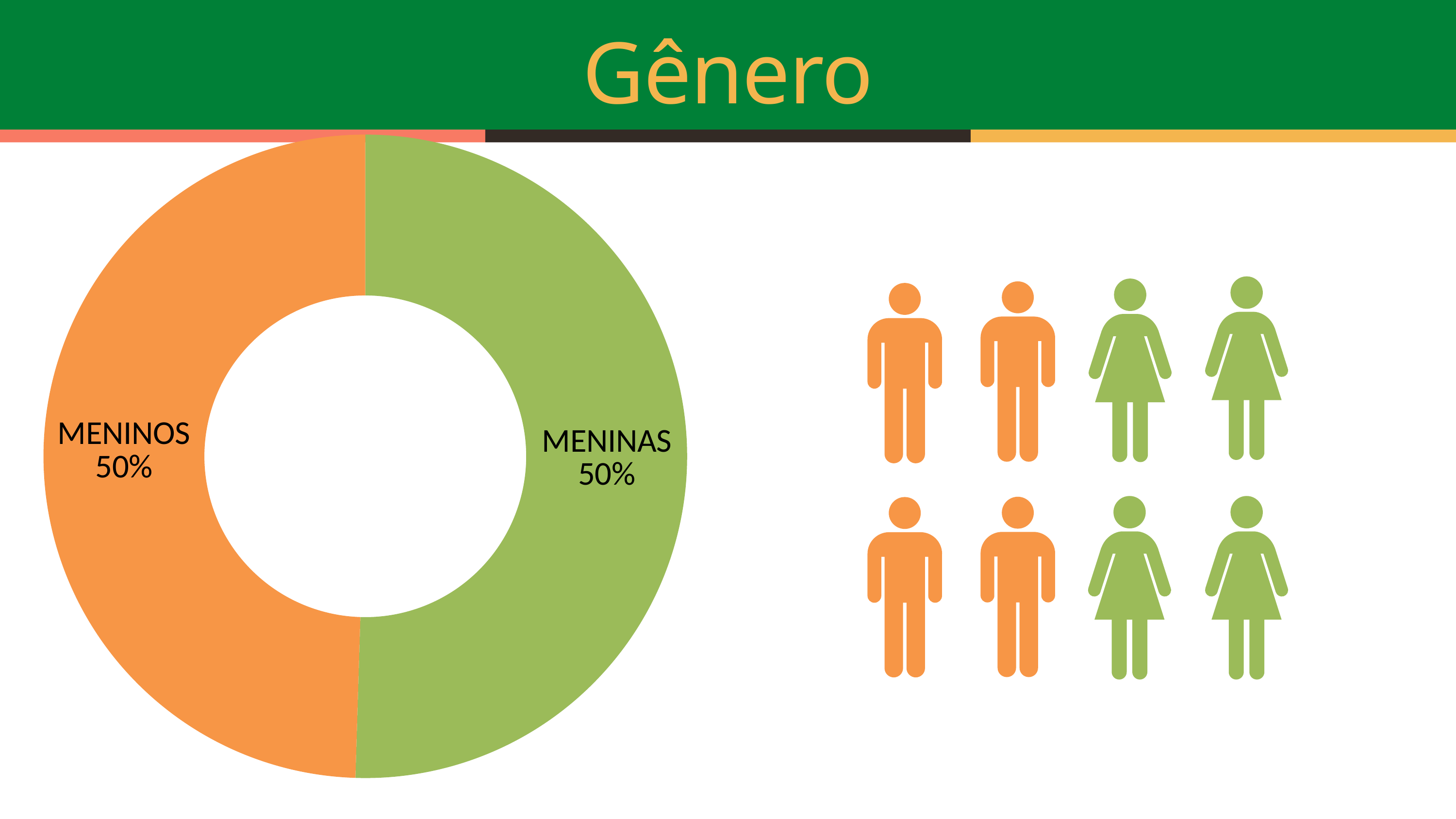
What colour is the MENINOS slice? Orange How many categories does the chart show? 2 What is the title of the slide? Gênero What is the value shown for MENINAS? 50% What share of the chart does the MENINAS slice represent? 50% What is the value shown for MENINOS? 50% What kind of chart is shown on the slide? Doughnut chart What is the difference between the values for MENINOS and MENINAS? 0% What is the total of the two slices shown? 100%